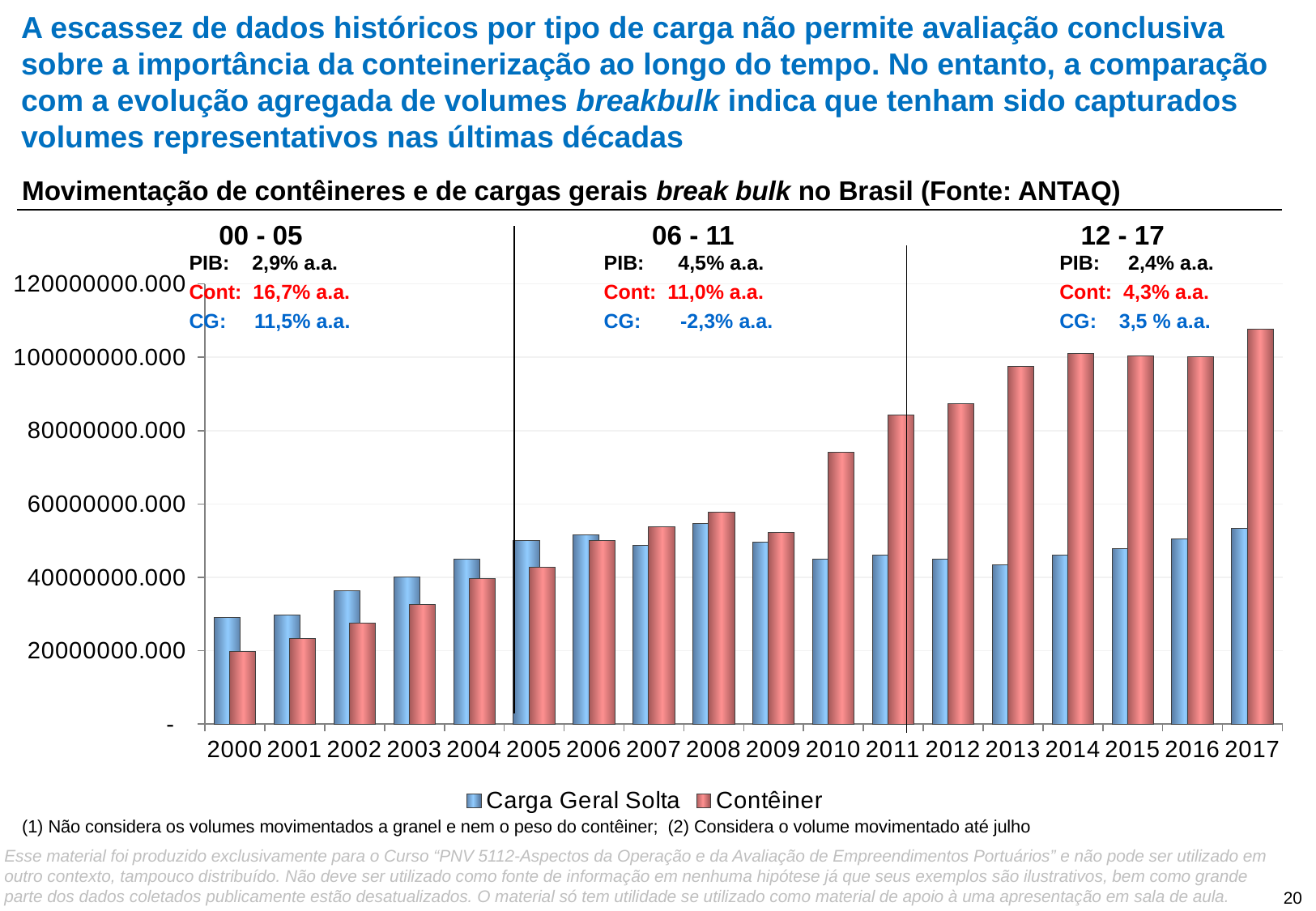
In 2000, which is larger: Carga Geral Solta or Contêiner? Carga Geral Solta In 2017, which is larger: Carga Geral Solta or Contêiner? Contêiner Which colour represents the Contêiner series in the legend? red What kind of chart is shown on the slide? bar chart Do the Contêiner values generally rise or fall from 2000 to 2017? rise Is the Contêiner value for 2010 greater or less than 80000000.000? less Is the Carga Geral Solta value for 2008 greater or less than 60000000.000? less How many series does the legend list? 2 How many years are shown on the x axis? 18 In which year is the Contêiner value lowest? 2000 Is the Contêiner value for 2017 greater or less than 100000000.000? greater In which year is the Contêiner value highest? 2017